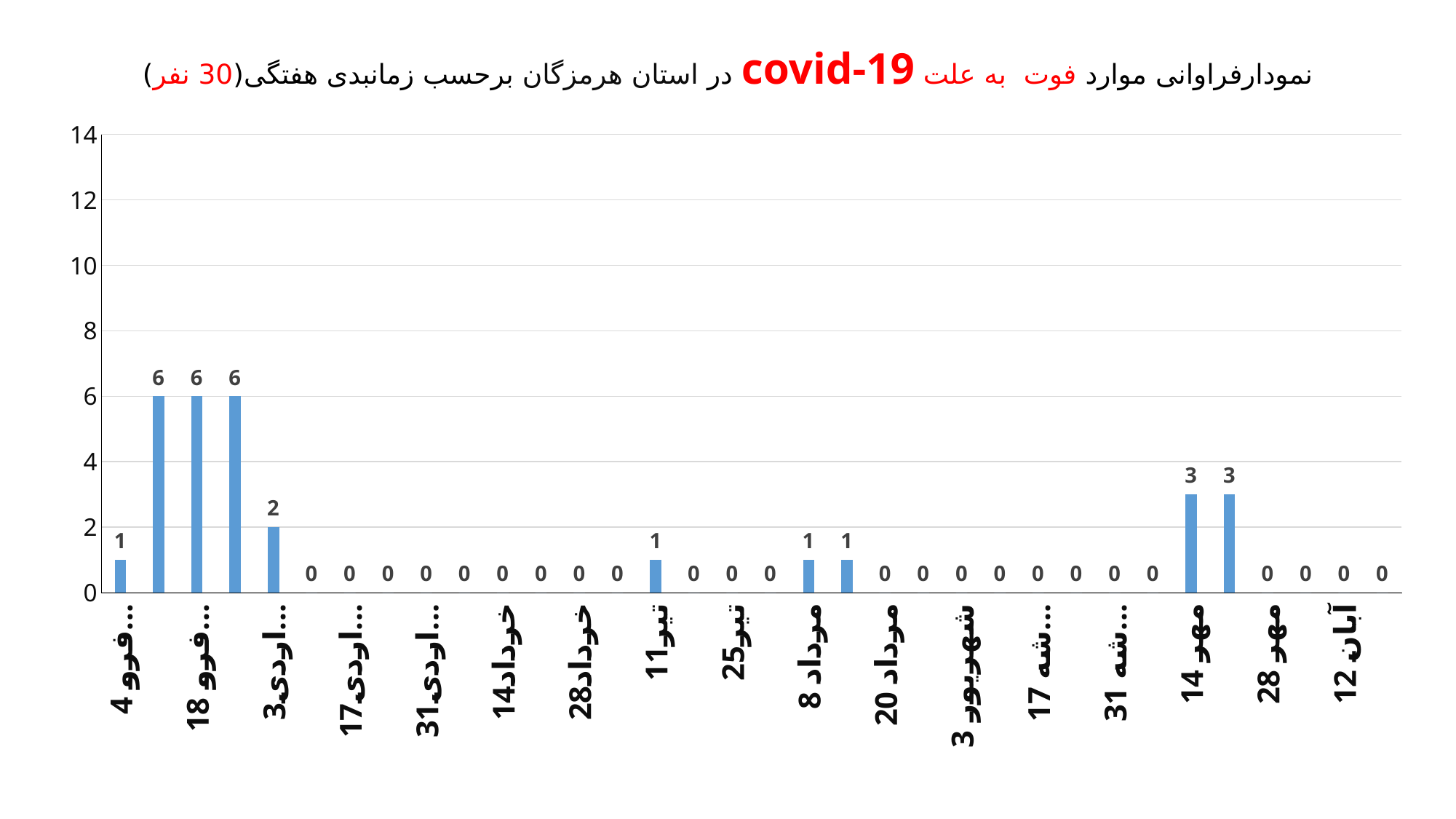
What kind of chart is shown on the slide? bar chart Which has the larger value, مهر 14 or اردی 3? مهر 14 Is the value for فرو 18 greater or less than 4? greater What is the value of the bar labelled مهر 14? 3 What is the value of the bar labelled اردی 3? 2 What is the value of the bar labelled تیر 11? 1 What is the value of the bar labelled آبان 12? 0 What is the highest value shown by any bar in the chart? 6 What total number of people is stated in parentheses in the chart title? 30 نفر What is the value of the bar labelled فرو 18? 6 What is the difference between the values for فرو 18 and اردی 3? 4 What is the value of the bar labelled فرو 4? 1